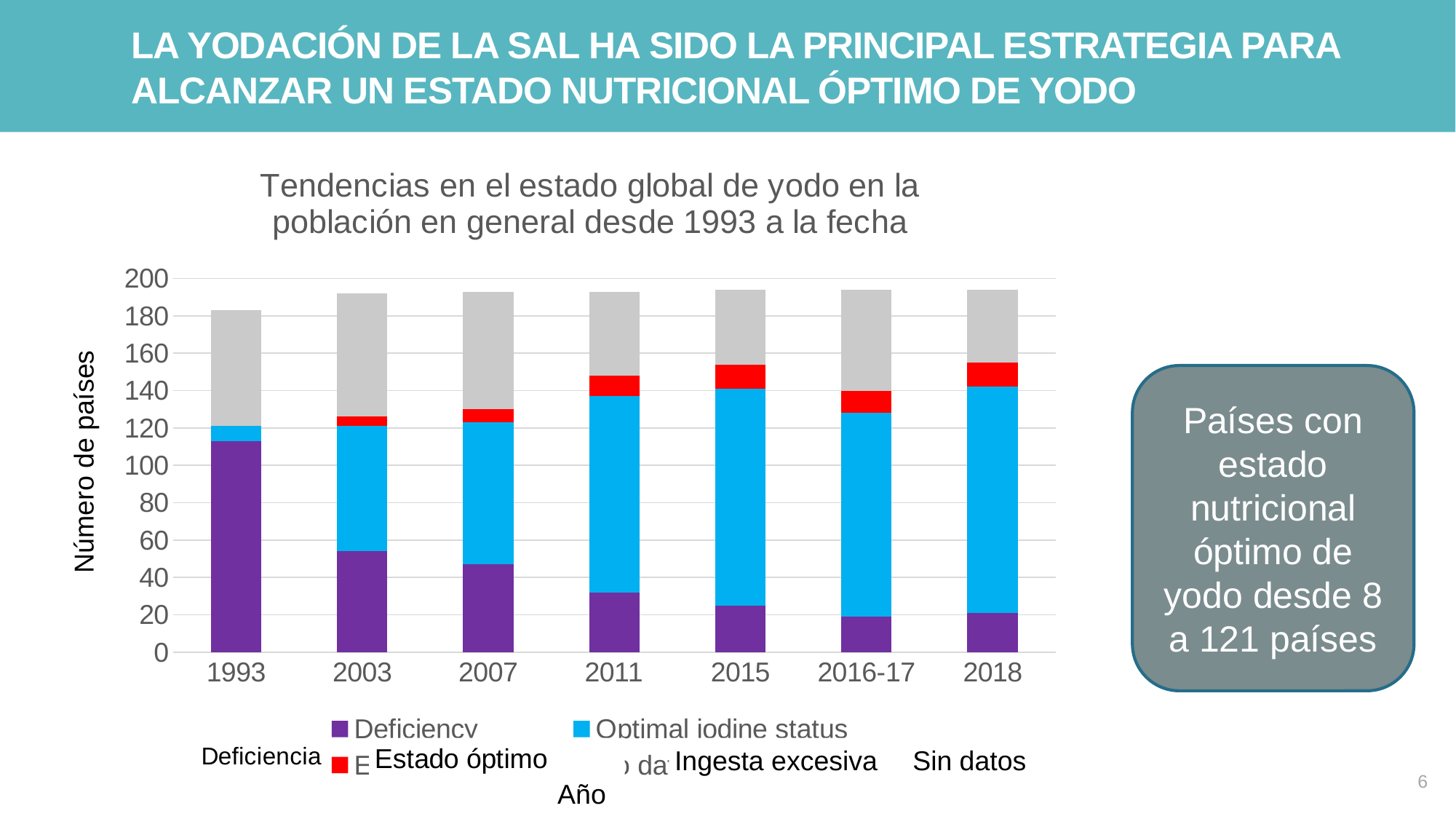
What kind of chart is shown on the slide? Stacked bar chart What is the label of the vertical axis of the chart? Número de países Is the total height of the 2018 bar greater or less than 180? greater How many years (categories) are shown on the x axis of the chart? 7 Is the Deficiency (purple) value for 1993 greater or less than 100? greater Which year has the largest Deficiency (purple) segment? 1993 How many series does the chart's legend list? 4 Is the Deficiency (purple) value for 2003 greater or less than 40? greater What is the label of the horizontal axis of the chart? Año Does the Deficiency (purple) segment rise or fall from 1993 to 2015? falls Is the Deficiency (purple) segment larger in 1993 or in 2003? 1993